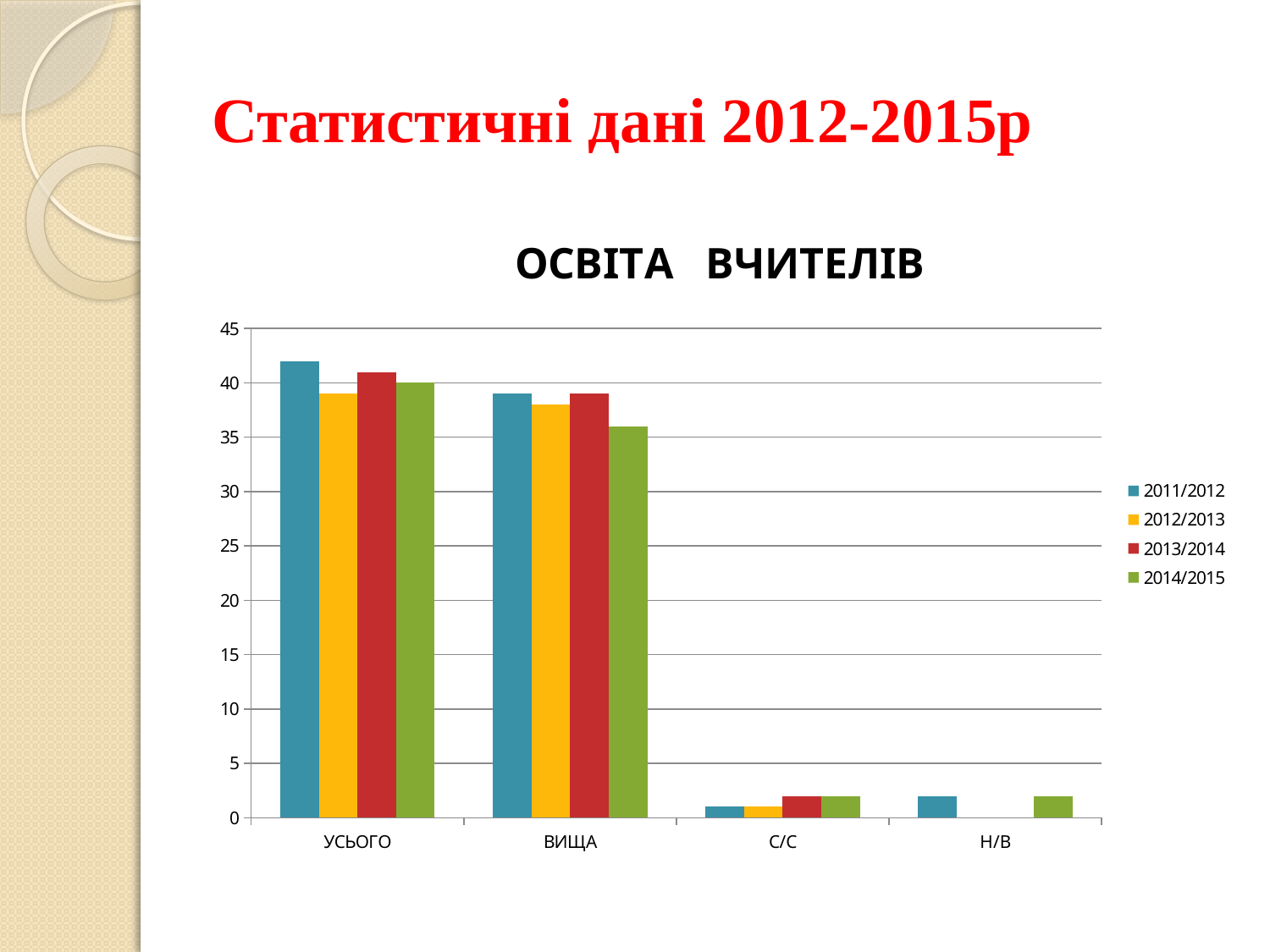
How many series does the legend list? 4 In the ВИЩА category, which is larger: the value for 2011/2012 or for 2014/2015? 2011/2012 Is the value for 2011/2012 in the ВИЩА category greater or less than 35? greater In the УСЬОГО category, which is larger: the value for 2011/2012 or for 2012/2013? 2011/2012 Is the value for 2014/2015 in the ВИЩА category greater or less than 40? less What kind of chart is shown on the slide? bar chart What is the title of the chart? ОСВІТА ВЧИТЕЛІВ How many categories are shown on the x axis? 4 Which category has the tallest bars? УСЬОГО Is the value for 2011/2012 in the УСЬОГО category greater or less than 40? greater Which colour represents the 2014/2015 series in the legend? green